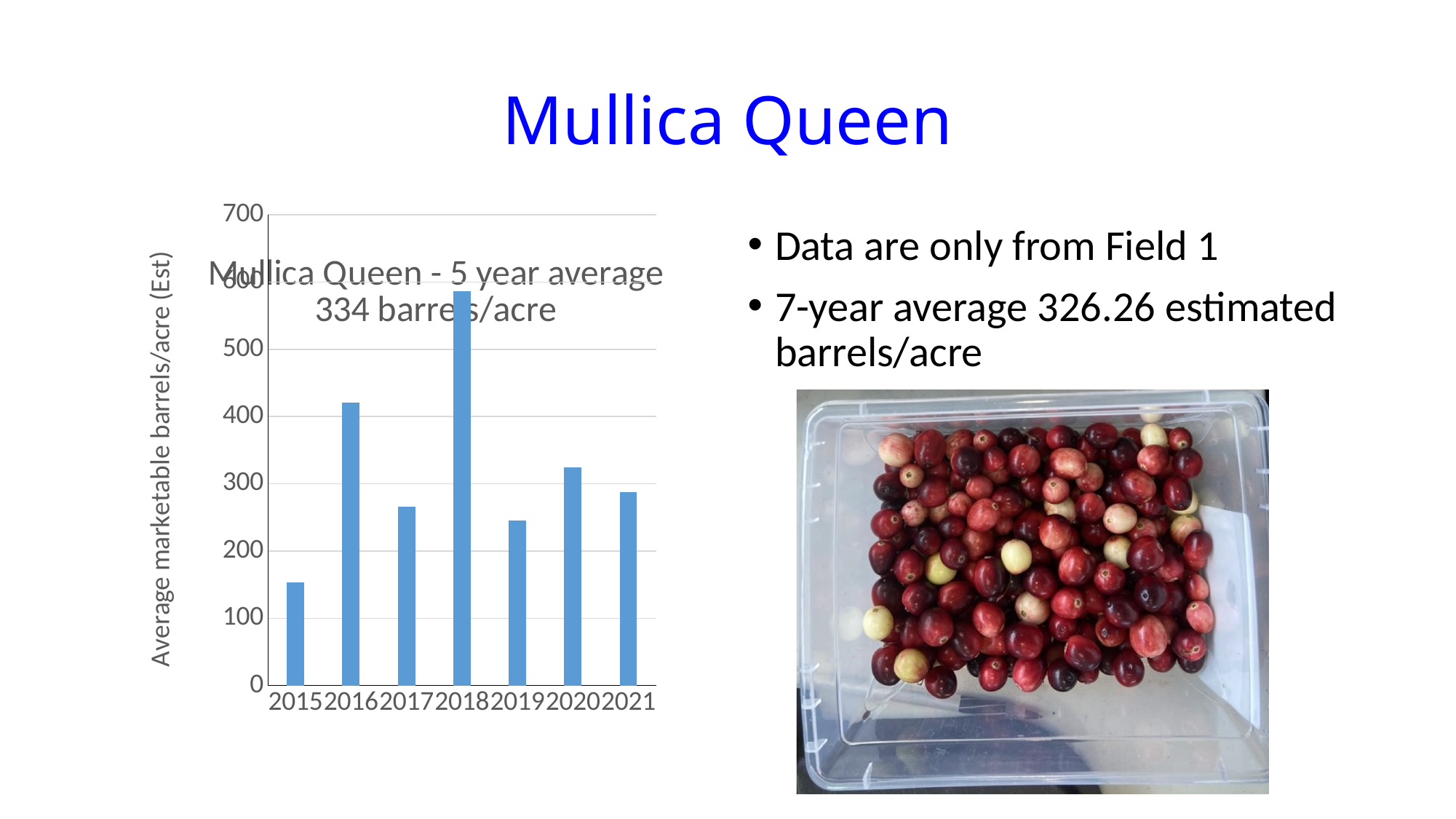
Which year has the larger value, 2020 or 2019? 2020 Is the value for 2019 greater or less than 300? less Is the value for 2018 greater or less than 500? greater What is the label on the y axis of the chart? Average marketable barrels/acre (Est) Which year has the larger value, 2016 or 2017? 2016 Does the value rise or fall from 2018 to 2019? fall Is the value for 2016 greater or less than 400? greater Which year has the highest bar in the chart? 2018 What kind of chart is shown on the slide? bar chart Which year has the lowest bar in the chart? 2015 How many years are plotted on the x axis of the chart? 7